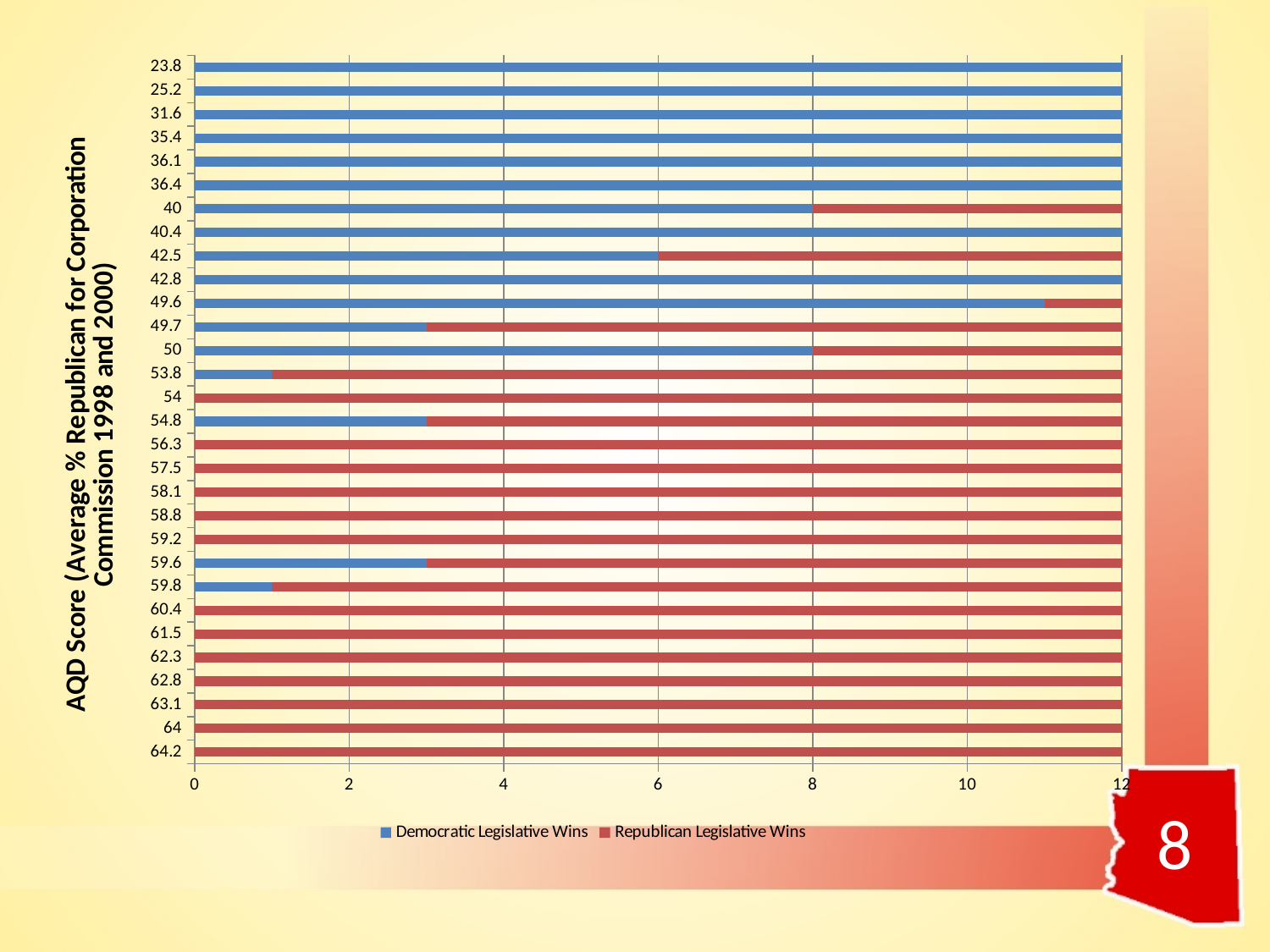
Is the value of Democratic Legislative Wins for the AQD score of 49.6 greater or less than 10? greater How many AQD score categories are plotted on the y axis? 30 What is the value of Democratic Legislative Wins for the AQD score of 40? 8 How many series does the legend list? 2 For the AQD score of 40, which series has the larger value, Democratic Legislative Wins or Republican Legislative Wins? Democratic Legislative Wins What kind of chart is shown on the slide? bar chart What is the value of Republican Legislative Wins for the AQD score of 64.2? 12 What is the title of the vertical axis? AQD Score (Average % Republican for Corporation Commission 1998 and 2000) What is the value of Republican Legislative Wins for the AQD score of 42.5? 6 What is the value of Democratic Legislative Wins for the AQD score of 23.8? 12 Is the value of Democratic Legislative Wins for the AQD score of 53.8 greater or less than 2? less What is the total of the stacked bar for the AQD score of 50? 12